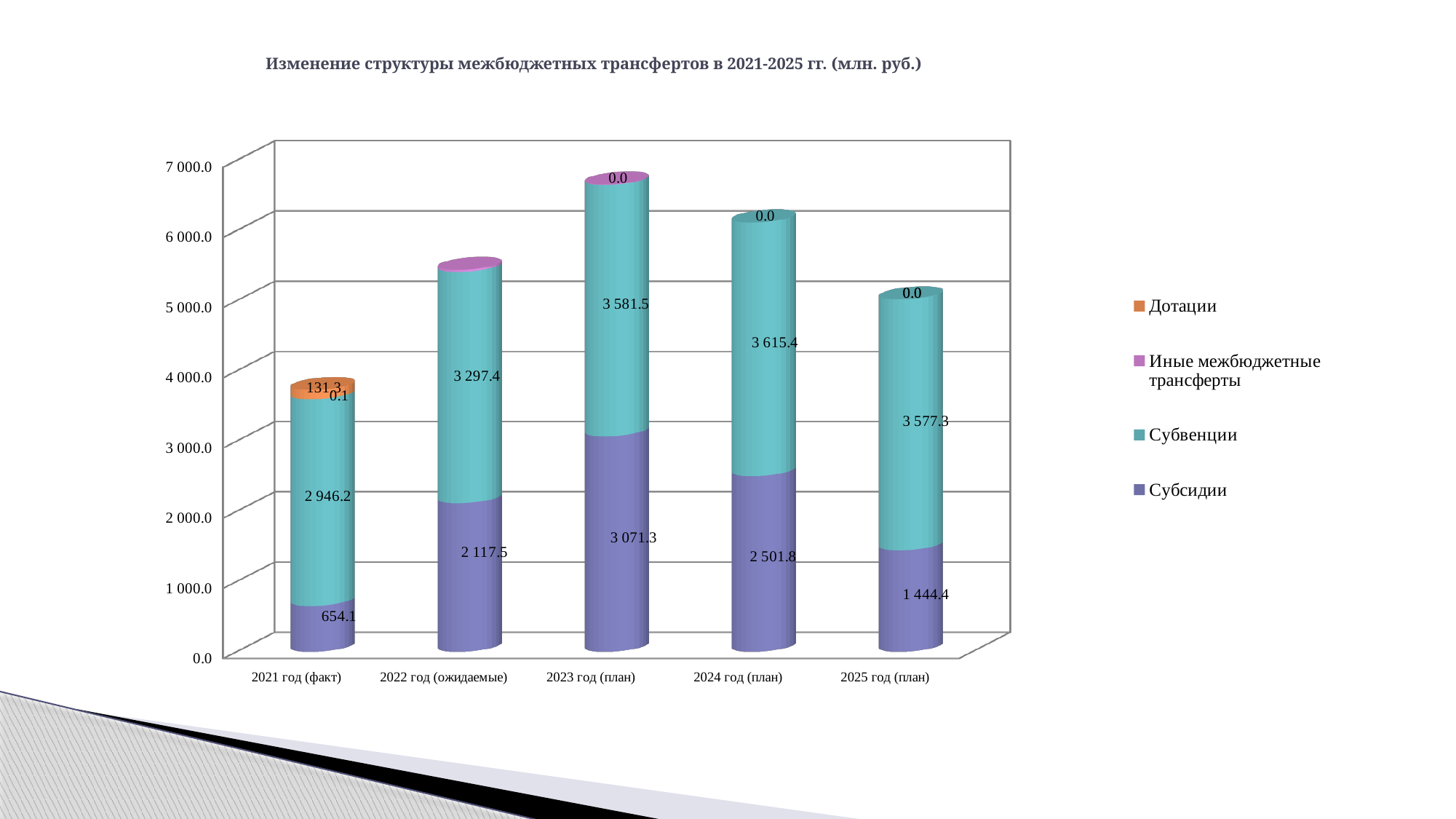
How many series does the legend list? 4 What kind of chart is shown on the slide? Stacked bar chart What is the value of Дотации for 2021 год (факт)? 131.3 In which year is the Субсидии value the highest? 2023 год (план) What is the value of Субвенции for 2024 год (план)? 3 615.4 In which year is the Субсидии value the lowest? 2021 год (факт) Is the total height of the 2022 год (ожидаемые) bar greater or less than 5 000.0? greater Which is larger: Субсидии for 2024 год (план) or Субсидии for 2025 год (план)? 2024 год (план) What is the value of Субсидии for 2021 год (факт)? 654.1 What is the difference between the Субвенции values for 2023 год (план) and 2022 год (ожидаемые)? 284.1 How many years (categories) are shown on the x axis? 5